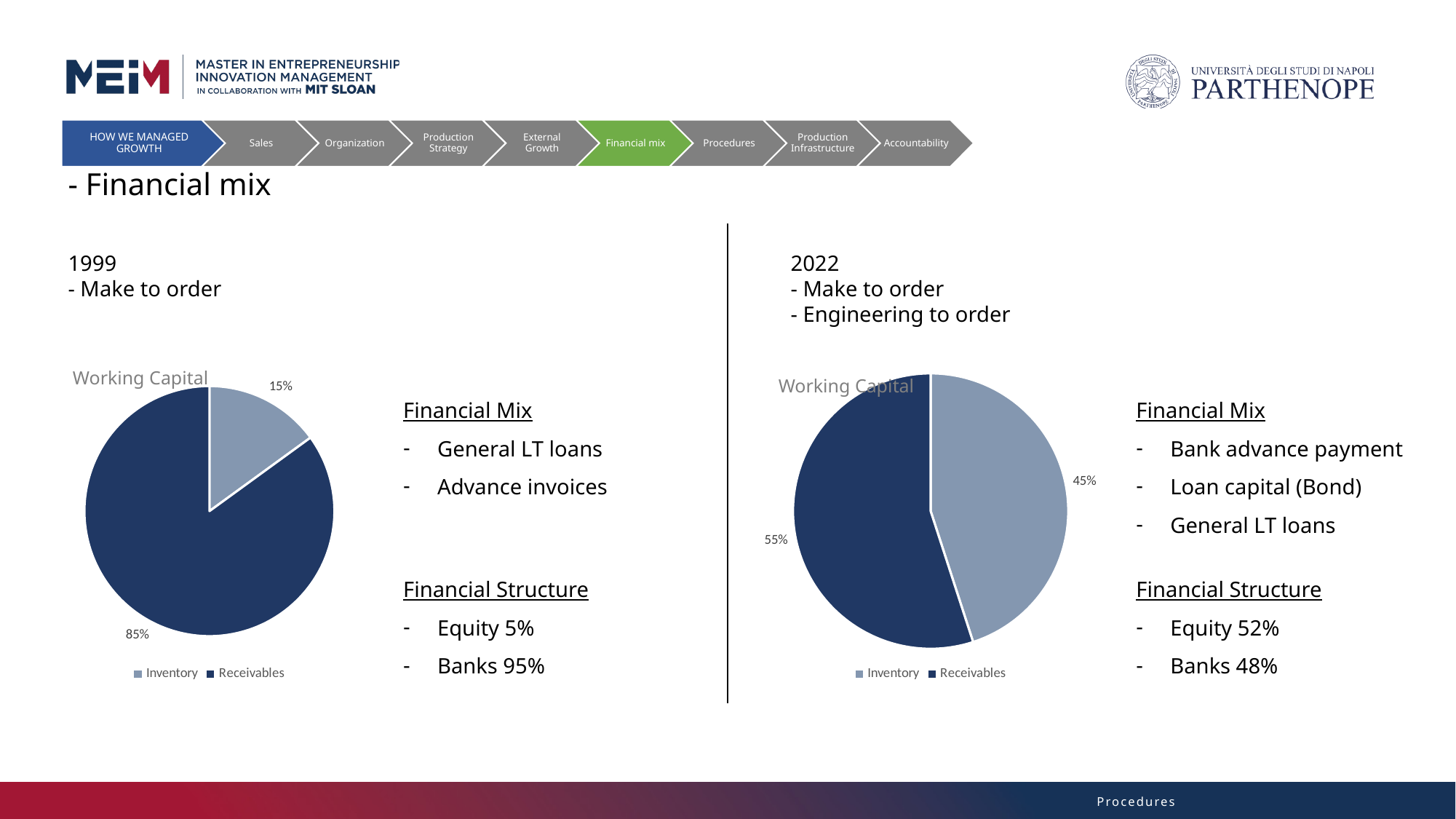
In the 2022 Working Capital pie chart on the right, what is the difference between the Receivables and Inventory shares? 10% In the 2022 Working Capital pie chart on the right, which slice is the smallest? Inventory In the 1999 Working Capital pie chart on the left, what is the difference between the Receivables and Inventory shares? 70% What type of chart is used for Working Capital on the left side of the slide? Pie chart What are the two legend entries of the 1999 Working Capital pie chart on the left? Inventory and Receivables In the 1999 Working Capital pie chart on the left, which slice is the largest? Receivables In the 2022 Working Capital pie chart on the right, what share is Receivables? 55% In the 2022 Working Capital pie chart on the right, what share is Inventory? 45% In the 1999 Working Capital pie chart on the left, what share is Inventory? 15% In the 1999 Working Capital pie chart on the left, what share is Receivables? 85% How many slices does the 2022 Working Capital pie chart on the right have? 2 Which is larger: the Inventory share in the 1999 pie chart on the left or the Inventory share in the 2022 pie chart on the right? 2022